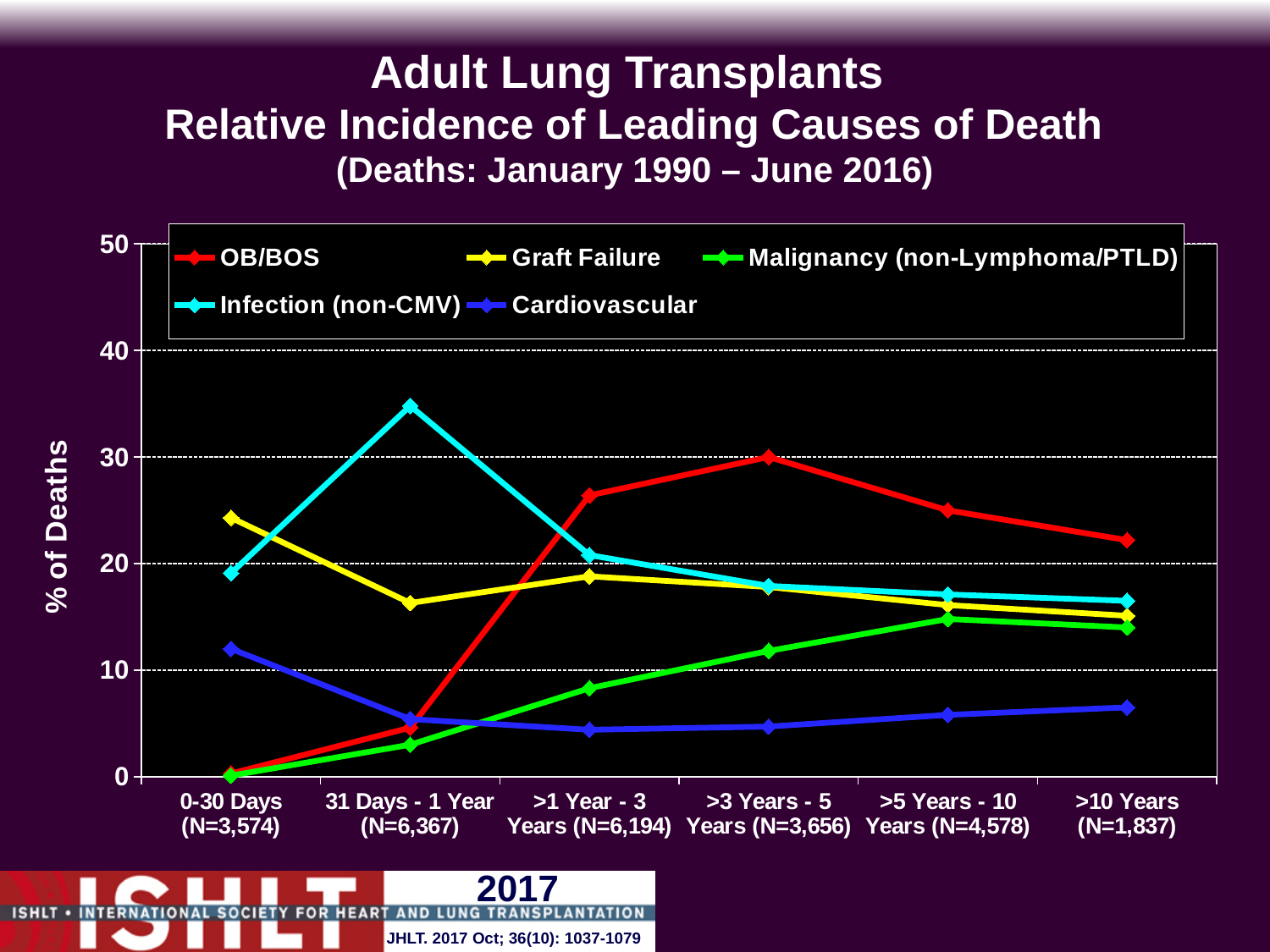
In the 0-30 Days period, which is larger: Graft Failure or Infection (non-CMV)? Graft Failure How many series does the legend list? 5 Is the value for OB/BOS in the >3 Years - 5 Years period greater or less than 20? greater What kind of chart is shown on the slide? line chart What is the label on the y axis? % of Deaths Does the Malignancy (non-Lymphoma/PTLD) line rise or fall from 0-30 Days to >5 Years - 10 Years? rise Is the value for Cardiovascular in the 0-30 Days period greater or less than 10? greater Which cause of death has the highest % of deaths in the >3 Years - 5 Years period? OB/BOS Which cause of death has the highest % of deaths in the 31 Days - 1 Year period? Infection (non-CMV) Which cause of death has the lowest % of deaths in the >10 Years period? Cardiovascular Is the value for Infection (non-CMV) in the 31 Days - 1 Year period greater or less than 30? greater How many time-period categories are shown on the x axis? 6